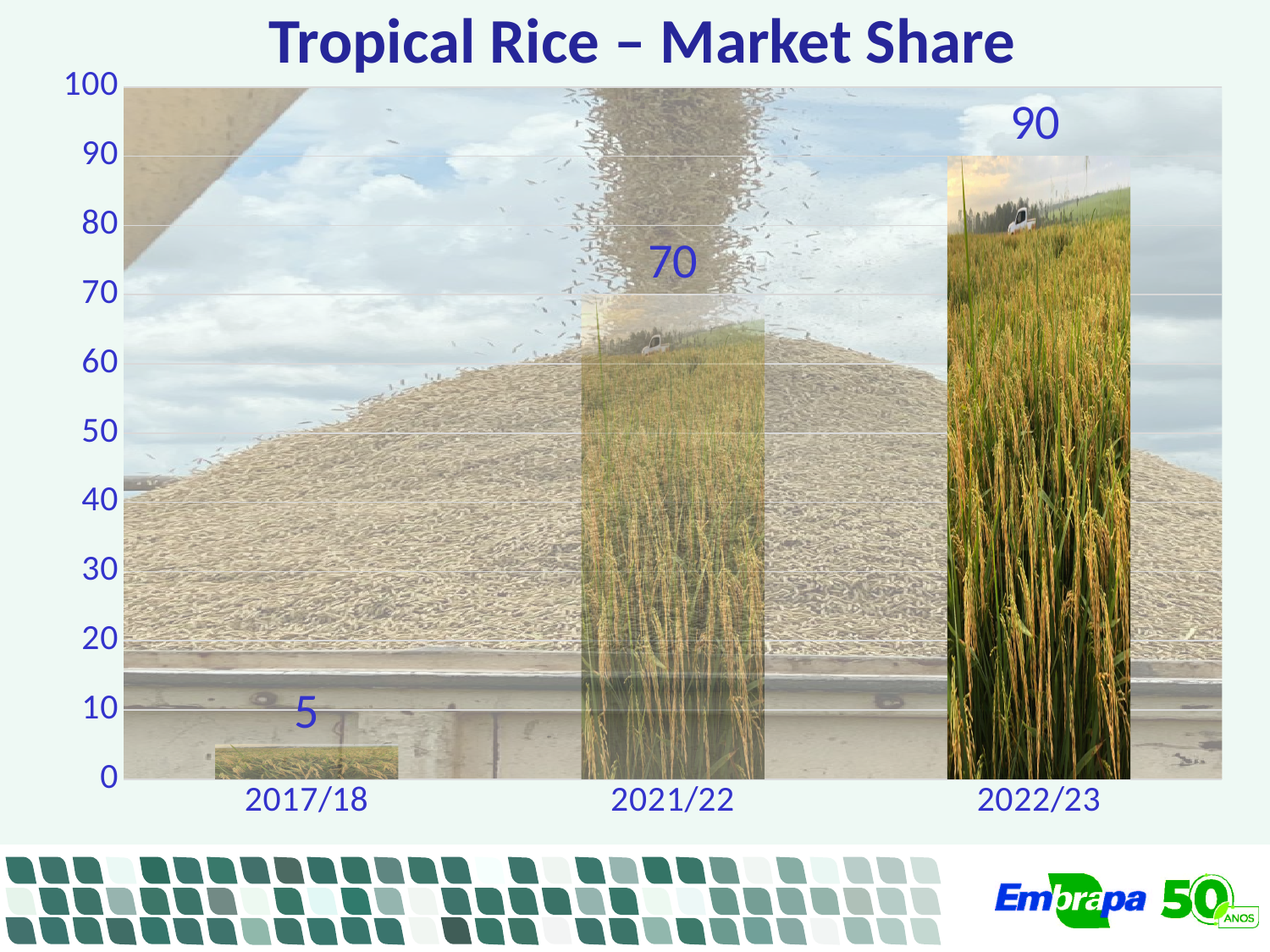
Which is larger, the value for 2017/18 or the value for 2021/22? 2021/22 What kind of chart is shown on the slide? Bar chart Which period has the lowest market share? 2017/18 Do the values rise or fall from 2017/18 to 2022/23? Rise What is the difference between the values for 2021/22 and 2017/18? 65 What is the market share value for 2022/23? 90 How many periods are shown on the x axis? 3 What is the difference between the values for 2022/23 and 2021/22? 20 What is the market share value for 2017/18? 5 Which period has the highest market share? 2022/23 What is the market share value for 2021/22? 70 What is the title of the chart? Tropical Rice – Market Share